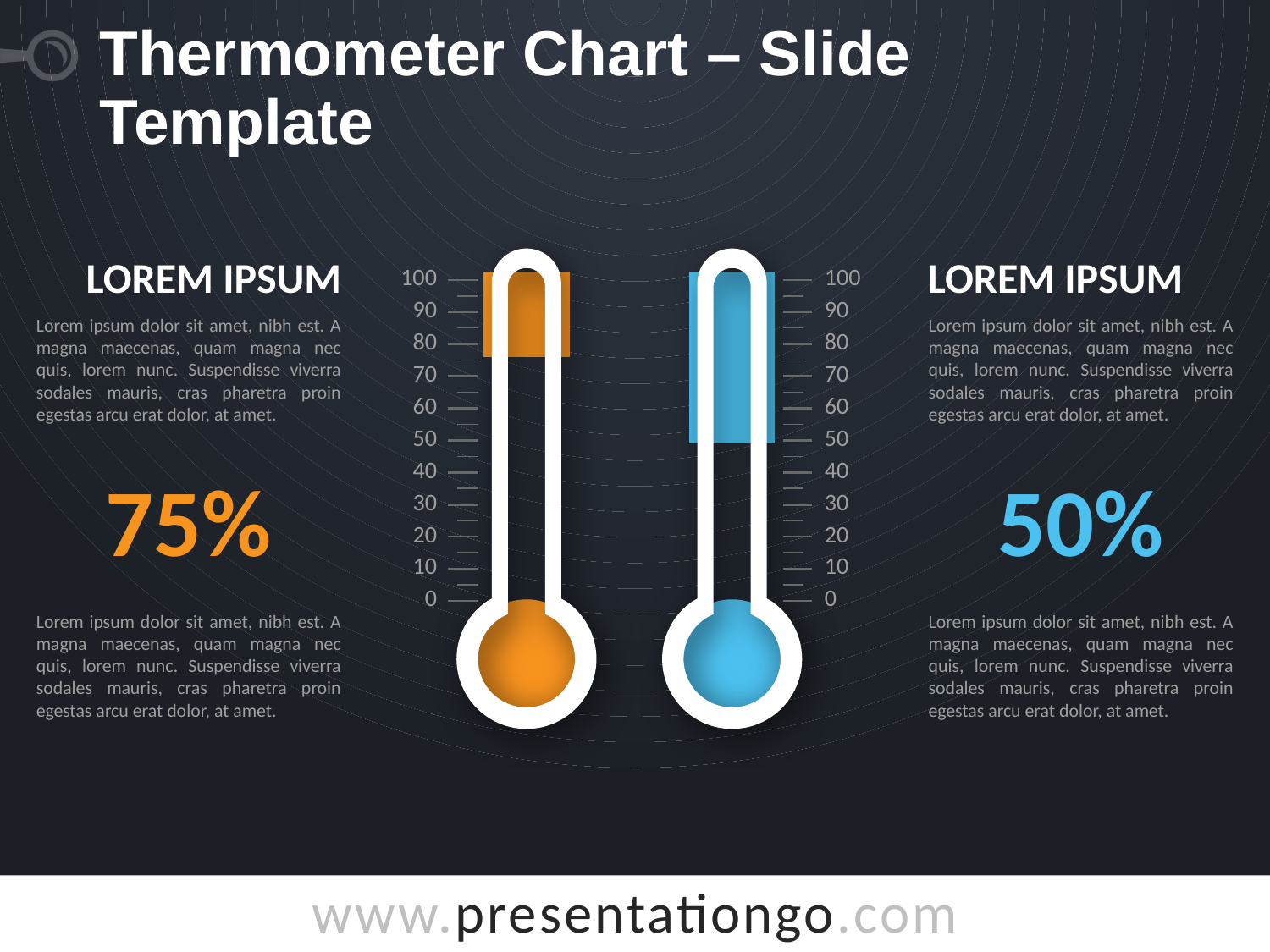
What kind of chart is shown on the slide? Thermometer chart What value is shown for the blue thermometer on the right? 50% Is the value of the blue thermometer greater or less than 80? less Which thermometer shows the higher value, the orange one or the blue one? The orange one What is the minimum value marked on the thermometer scales? 0 Which thermometer shows the lowest value? The blue one What is the title of the slide? Thermometer Chart – Slide Template What is the maximum value marked on the thermometer scales? 100 Is the value of the orange thermometer greater or less than 50? greater How many thermometers are shown on the slide? 2 What value is shown for the orange thermometer on the left? 75% What is the difference between the orange thermometer's value and the blue thermometer's value? 25%